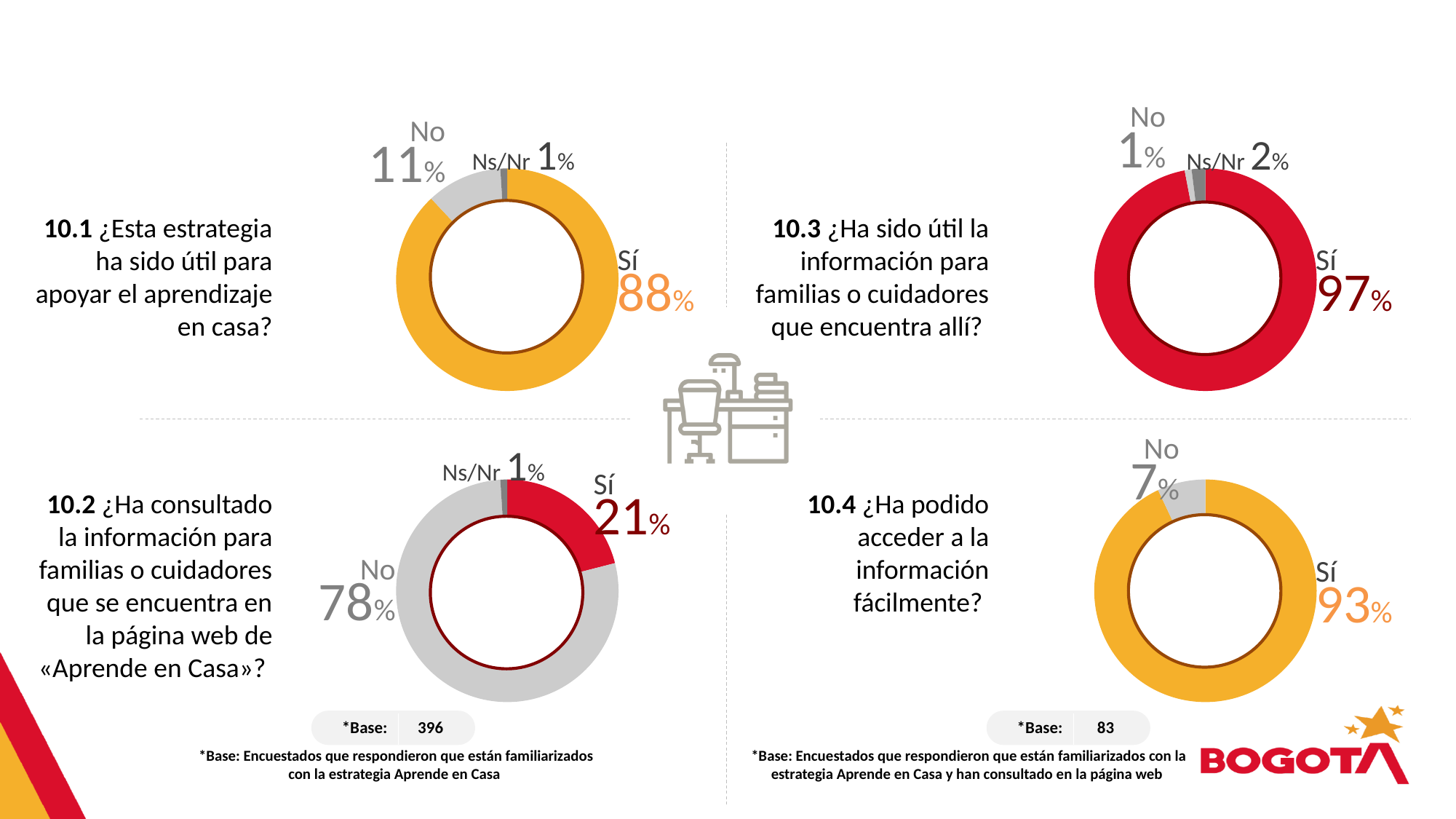
In the chart for question 10.2 (bottom left), what percentage answered No? 78% In the chart for question 10.1 (top left), what percentage answered No? 11% What kind of chart is used for question 10.3 (top right)? Donut chart In the chart for question 10.4 (bottom right), what percentage answered No? 7% In the chart for question 10.3 (top right), what percentage answered Sí? 97% What is the base (number of respondents) shown for the charts on the left side of the slide? 396 In the chart for question 10.3 (top right), which response has the smallest share? No In the chart for question 10.2 (bottom left), what is the difference between the No and Sí shares? 57% Which chart has the higher Sí share: question 10.1 (top left) or question 10.4 (bottom right)? 10.4 In the chart for question 10.1 (top left), what percentage answered Sí? 88% In the chart for question 10.4 (bottom right), how many response categories are shown? 2 In the chart for question 10.2 (bottom left), which response has the largest share? No